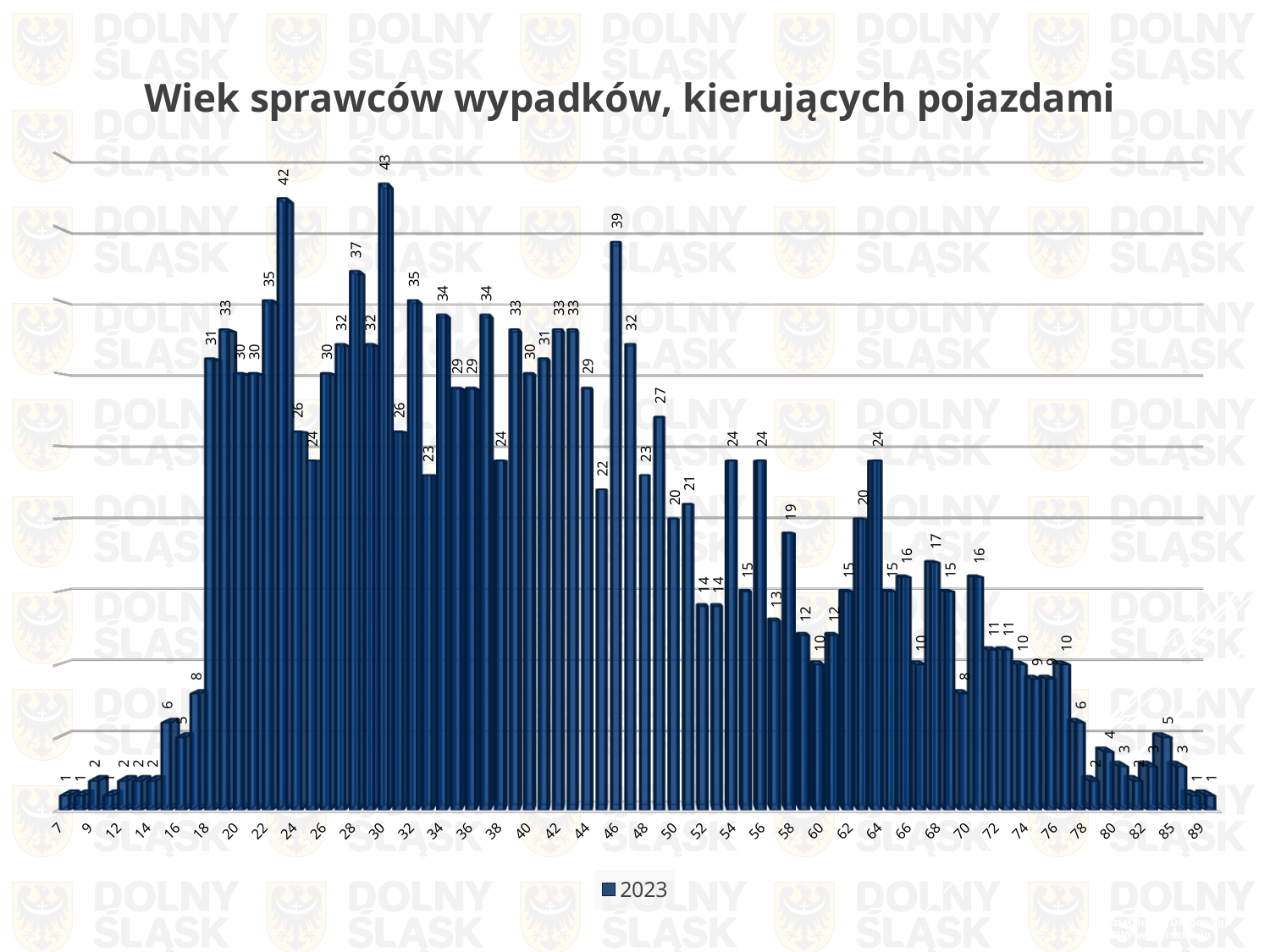
What is the lowest value shown on any bar in the chart? 1 How many series does the legend list? 1 What is the value for age 89? 1 What is the value for age 7? 1 What is the value for age 46? 39 What is the legend entry for the series shown? 2023 What is the title of the chart? Wiek sprawców wypadków, kierujących pojazdami What is the highest value shown on any bar in the chart? 43 Which is larger, the value for age 24 or the value for age 46? age 46 What is the value for age 24? 26 What kind of chart is shown on the slide? bar chart What is the difference between the two tallest bars (43 and 42)? 1